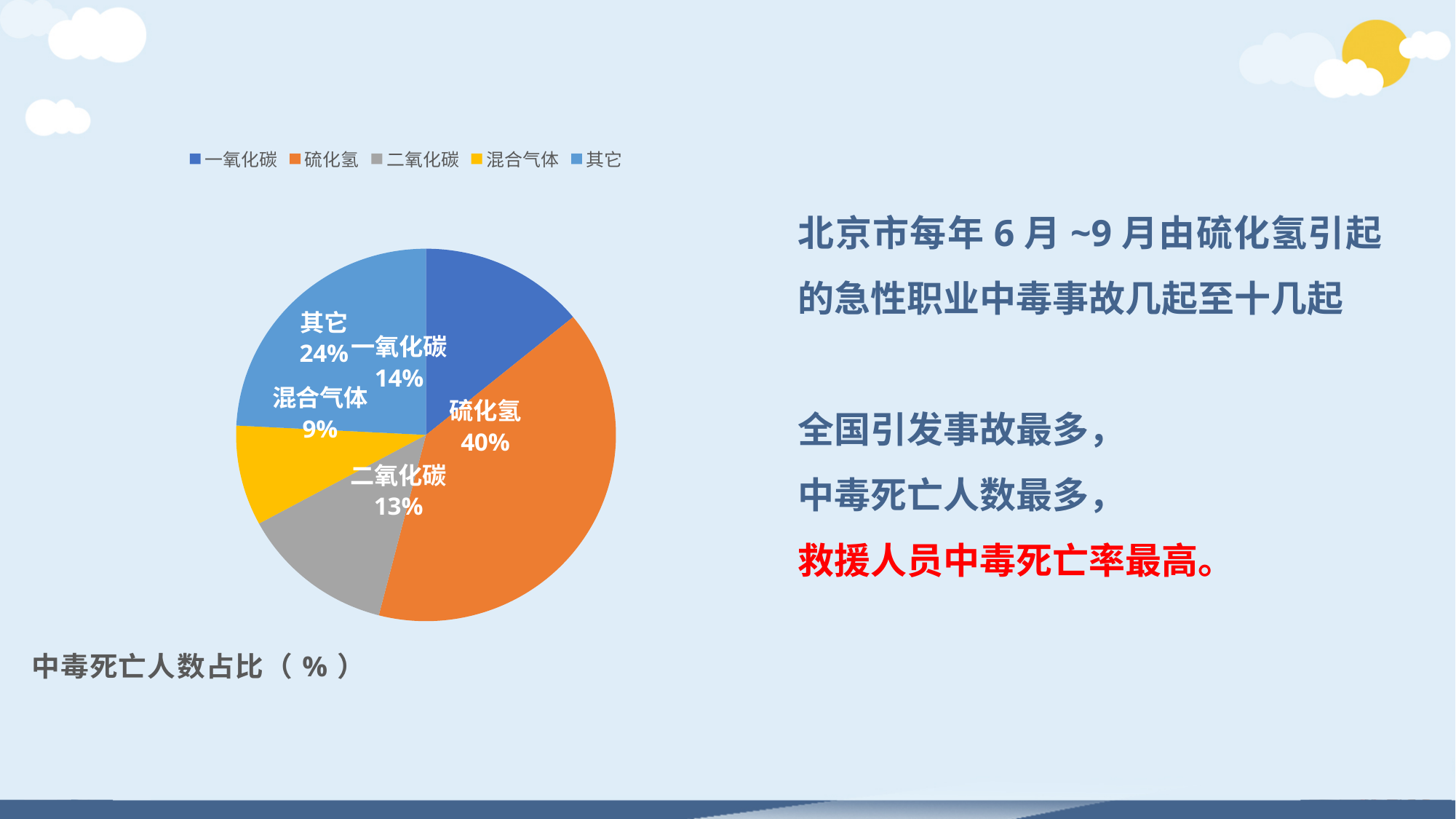
How many categories does the pie chart have? 5 What is the value shown for 其它? 24% What kind of chart is shown on the slide? pie chart What is the difference between the shares of 硫化氢 and 其它? 16% What colour is the 硫化氢 slice in the pie chart? orange What is the value shown for 一氧化碳? 14% Which category has the smallest share of the pie? 混合气体 Which is larger, the share of 其它 or the share of 一氧化碳? 其它 Which category has the largest share of the pie? 硫化氢 What is the value shown for 混合气体? 9% What share of the pie does 硫化氢 account for? 40% What is the value shown for 二氧化碳? 13%